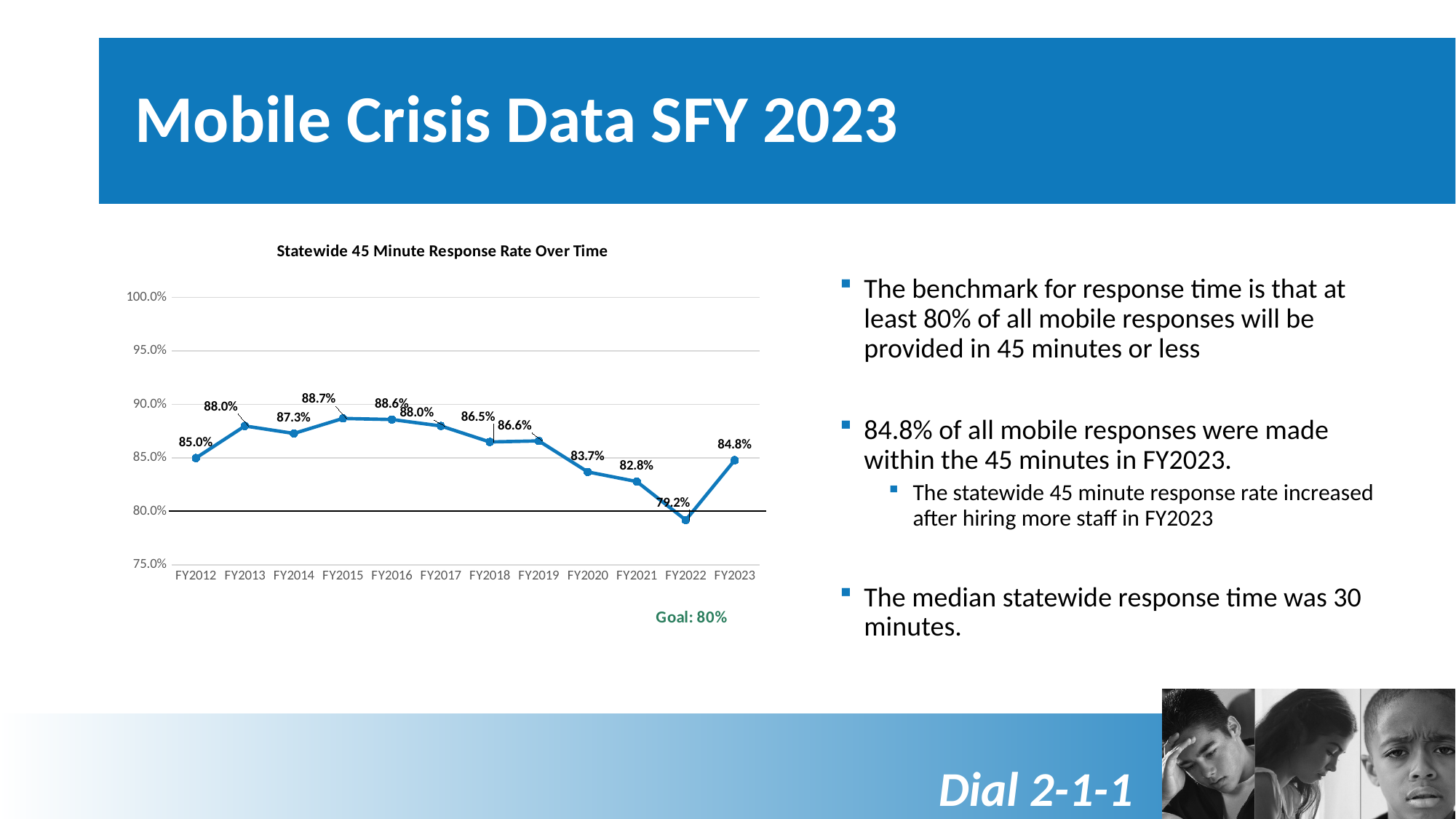
Which fiscal year has the highest 45 minute response rate? FY2015 How many fiscal years are plotted on the chart? 12 What is the 45 minute response rate for FY2023? 84.8% What is the 45 minute response rate for FY2012? 85.0% What is the title of the chart? Statewide 45 Minute Response Rate Over Time What is the 45 minute response rate for FY2022? 79.2% Which fiscal year has the lowest 45 minute response rate? FY2022 Does the response rate rise or fall from FY2019 to FY2022? fall What kind of chart is shown on the slide? line chart Which year has a higher response rate, FY2013 or FY2014? FY2013 Is the value for FY2022 greater or less than 80.0%? less What is the difference between the response rate in FY2023 and FY2022? 5.6%